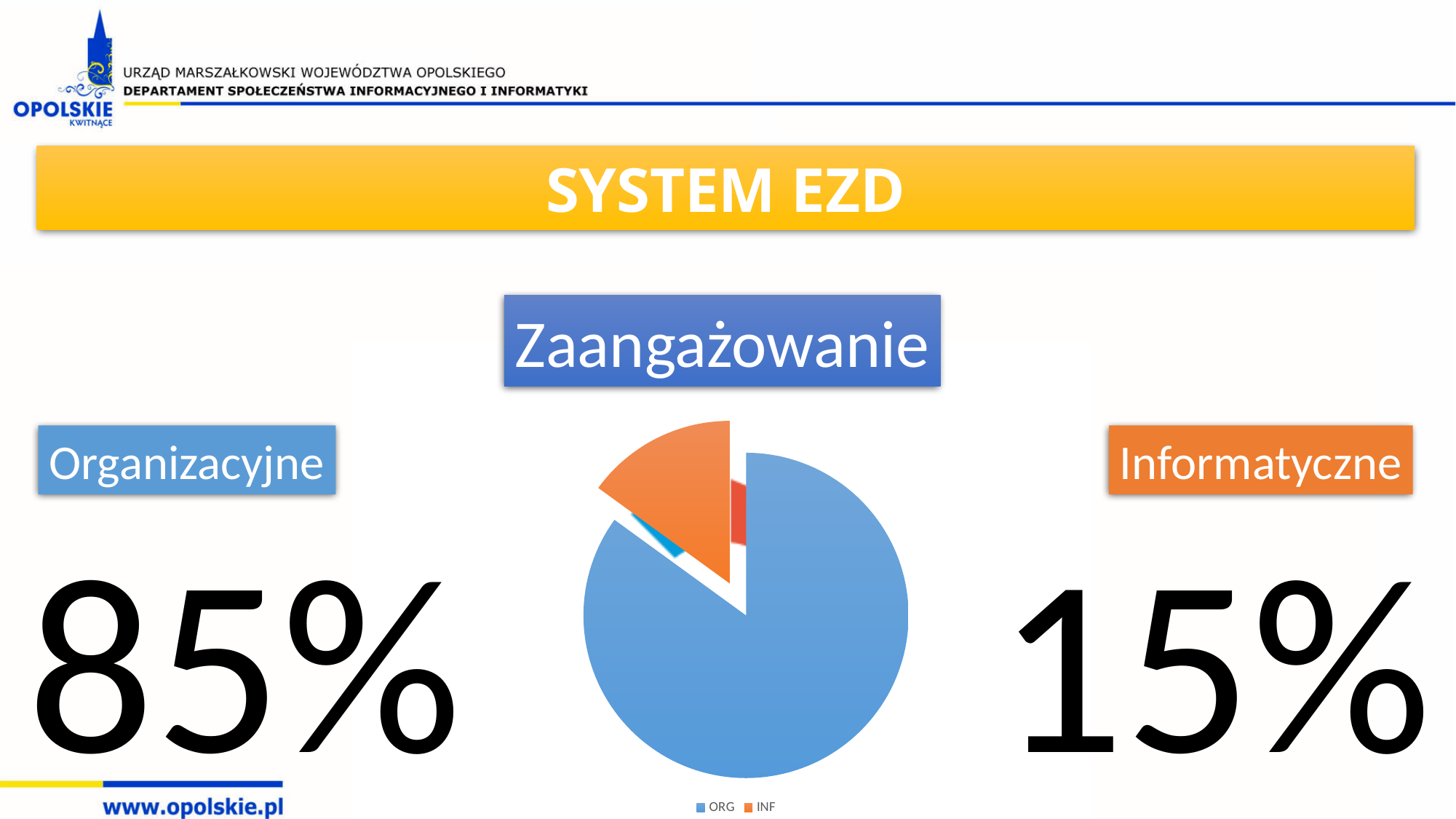
What share of the pie does the ORG (Organizacyjne) slice represent? 85% What are the two entries listed in the pie chart's legend? ORG and INF What colour is the INF slice of the pie chart? orange Which is larger, the Organizacyjne share or the Informatyczne share? Organizacyjne Which slice of the pie chart is the largest? ORG By how many percentage points does the Organizacyjne share exceed the Informatyczne share? 70 How many slices does the pie chart have? 2 How many entries does the legend of the pie chart list? 2 Which slice of the pie chart is the smallest? INF What kind of chart is shown on the slide? pie chart What share of the pie does the INF (Informatyczne) slice represent? 15%